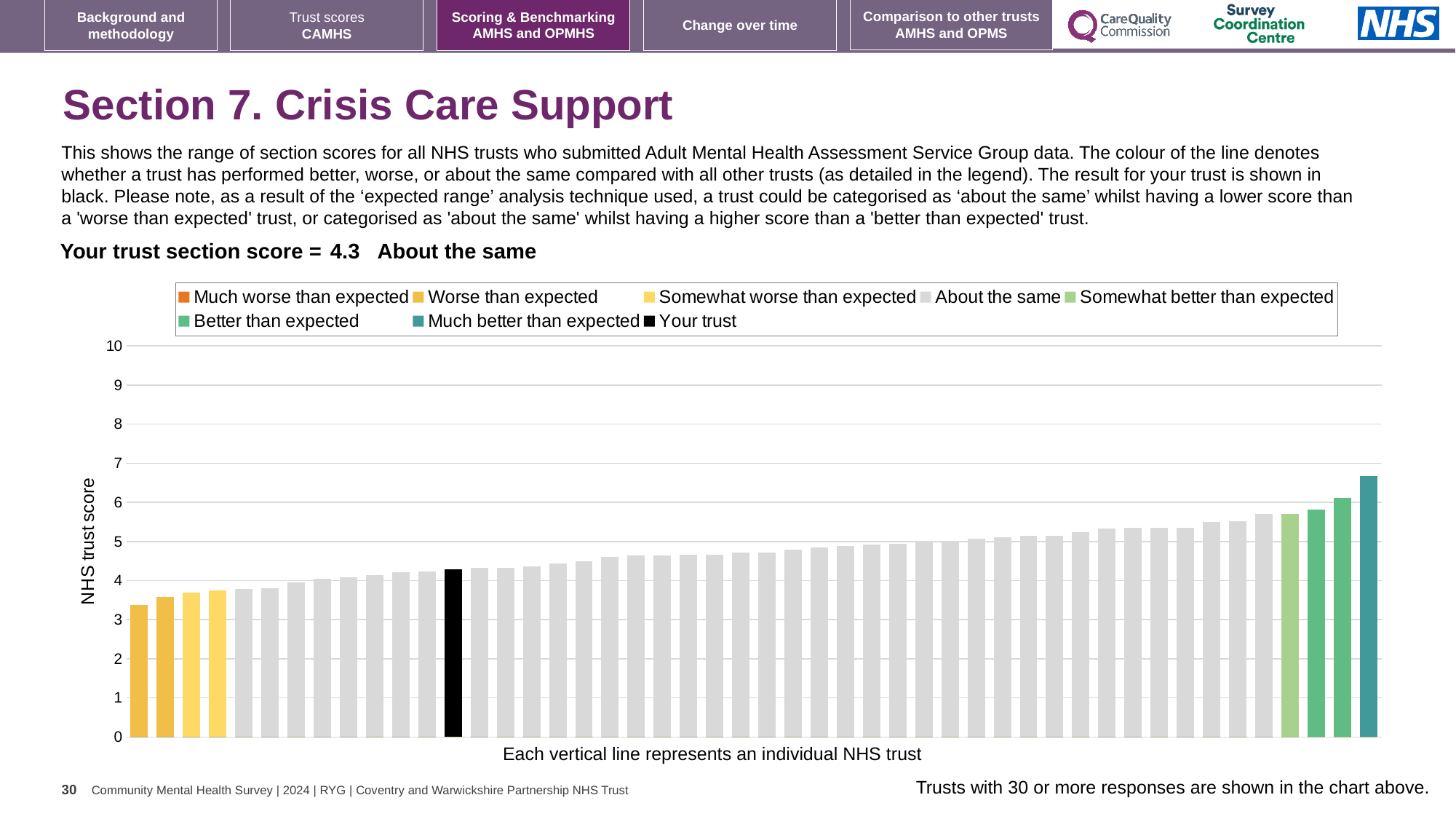
Is the value of the lowest bar greater or less than 3? greater Is the value of the lowest bar greater or less than 4? less Is the value for your trust (the black bar) greater or less than 5? less Which legend category does the highest bar belong to? Much better than expected What is the label on the vertical axis of the chart? NHS trust score Do the bar values rise or fall from left to right along the x axis? rise What colour is used for the bar representing your trust? black What kind of chart is shown on the slide? bar chart What is the section score for your trust shown on the slide? 4.3 How many categories does the chart legend list? 8